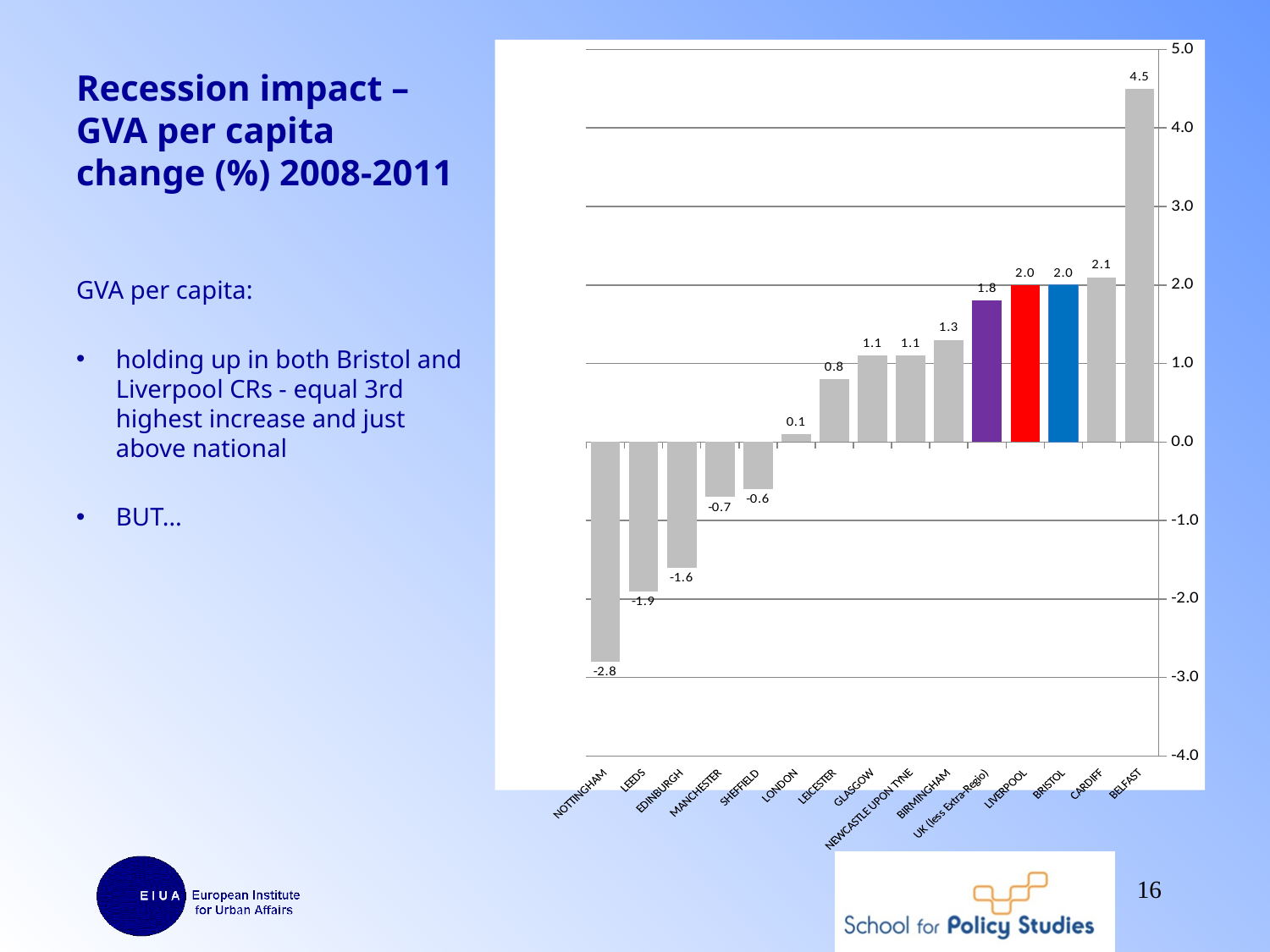
What is the difference between the values for Belfast and Cardiff? 2.4 What is the GVA per capita change (%) for Nottingham? -2.8 Do the values rise or fall from left to right along the x axis? Rise How many categories are plotted on the x axis? 15 Which has the larger value, Birmingham or Glasgow? Birmingham What kind of chart is shown on the slide? Bar chart Which city has the highest GVA per capita change? Belfast Which city has the lowest GVA per capita change? Nottingham What is the value shown for UK (less Extra-Regio)? 1.8 What is the difference between the values for Liverpool and UK (less Extra-Regio)? 0.2 What is the value shown for London? 0.1 What is the GVA per capita change (%) for Belfast? 4.5